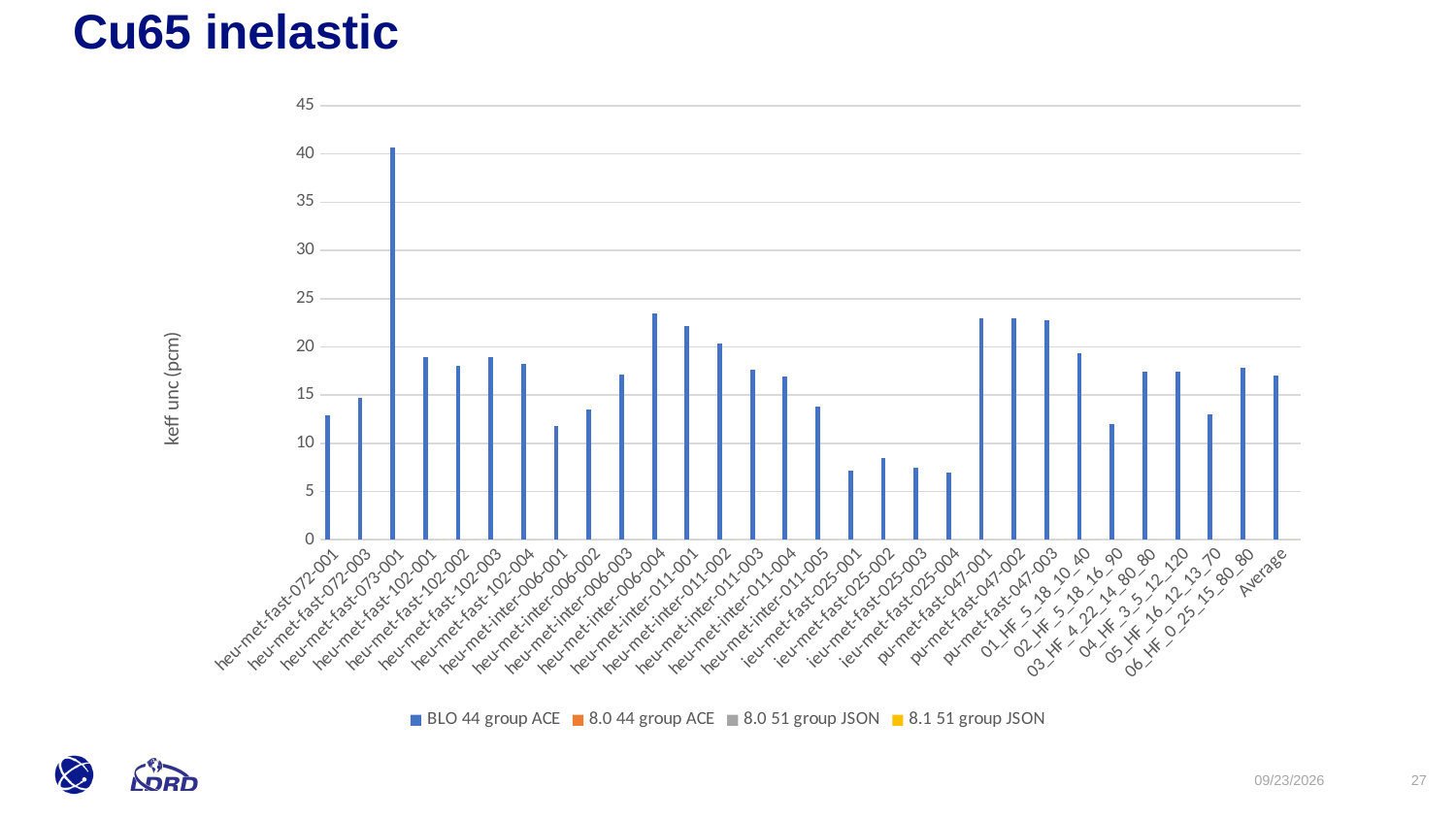
What kind of chart is shown on the slide? bar chart Which is larger, the value for pu-met-fast-047-001 or the value for ieu-met-fast-025-001? pu-met-fast-047-001 How many series does the legend list? 4 Is the value for heu-met-inter-006-004 greater or less than 20? greater Is the value for ieu-met-fast-025-002 greater or less than 10? less Which category has the highest keff unc (pcm) value? heu-met-fast-073-001 Which is larger, the value for heu-met-inter-006-001 or the value for heu-met-inter-006-003? heu-met-inter-006-003 What is the title of the slide containing the chart? Cu65 inelastic Is the value for heu-met-fast-073-001 greater or less than 35? greater How many categories are plotted along the x axis? 30 What is the label of the y axis? keff unc (pcm)